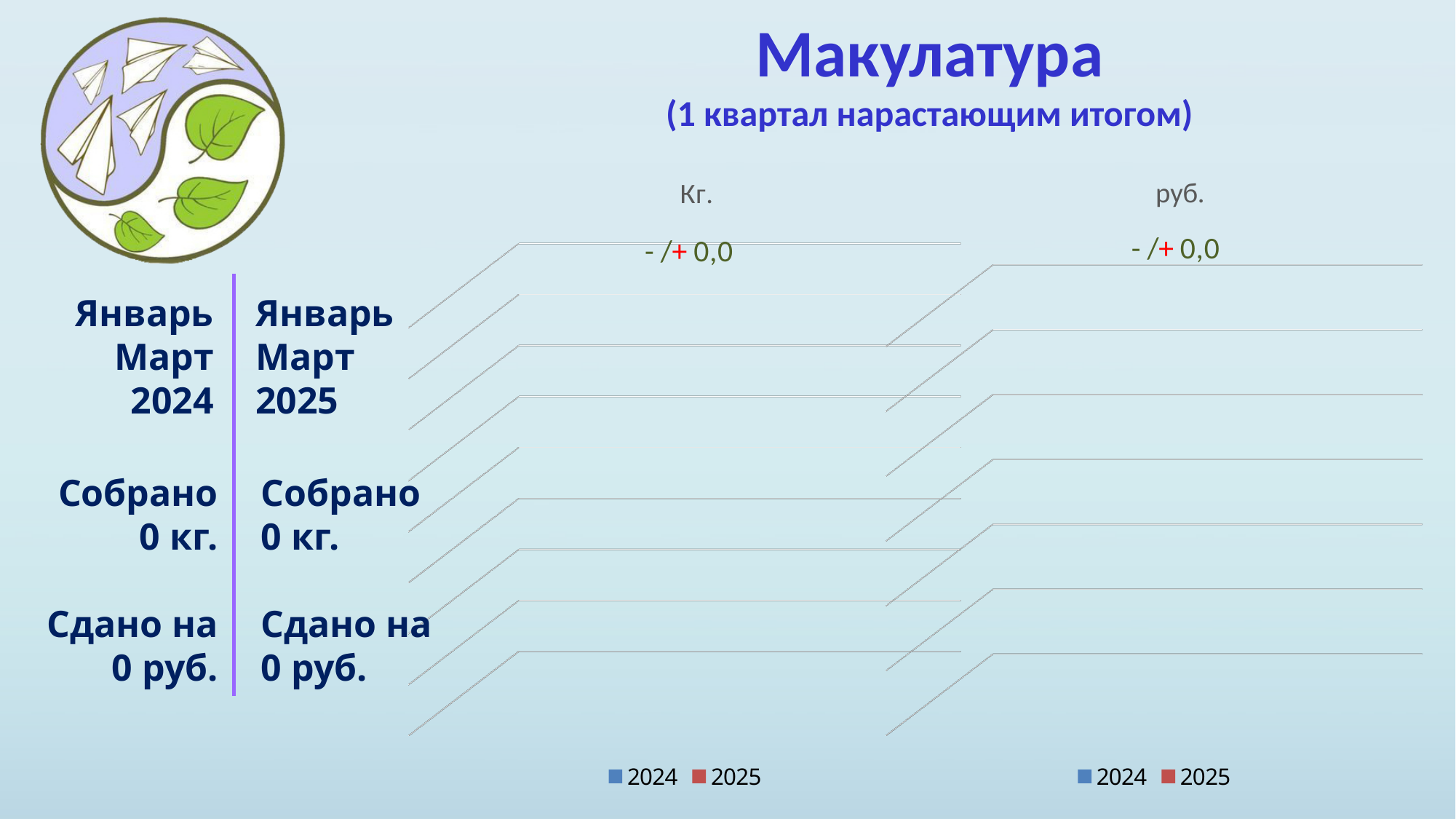
What are the legend entries of the left chart (Кг.)? 2024, 2025 How many series does the legend of the left chart (Кг.) list? 2 How many series does the legend of the right chart (руб.) list? 2 What is the title of the right chart? руб. What value is shown in the change label (- /+) above the right chart (руб.)? 0,0 What value is shown in the change label (- /+) above the left chart (Кг.)? 0,0